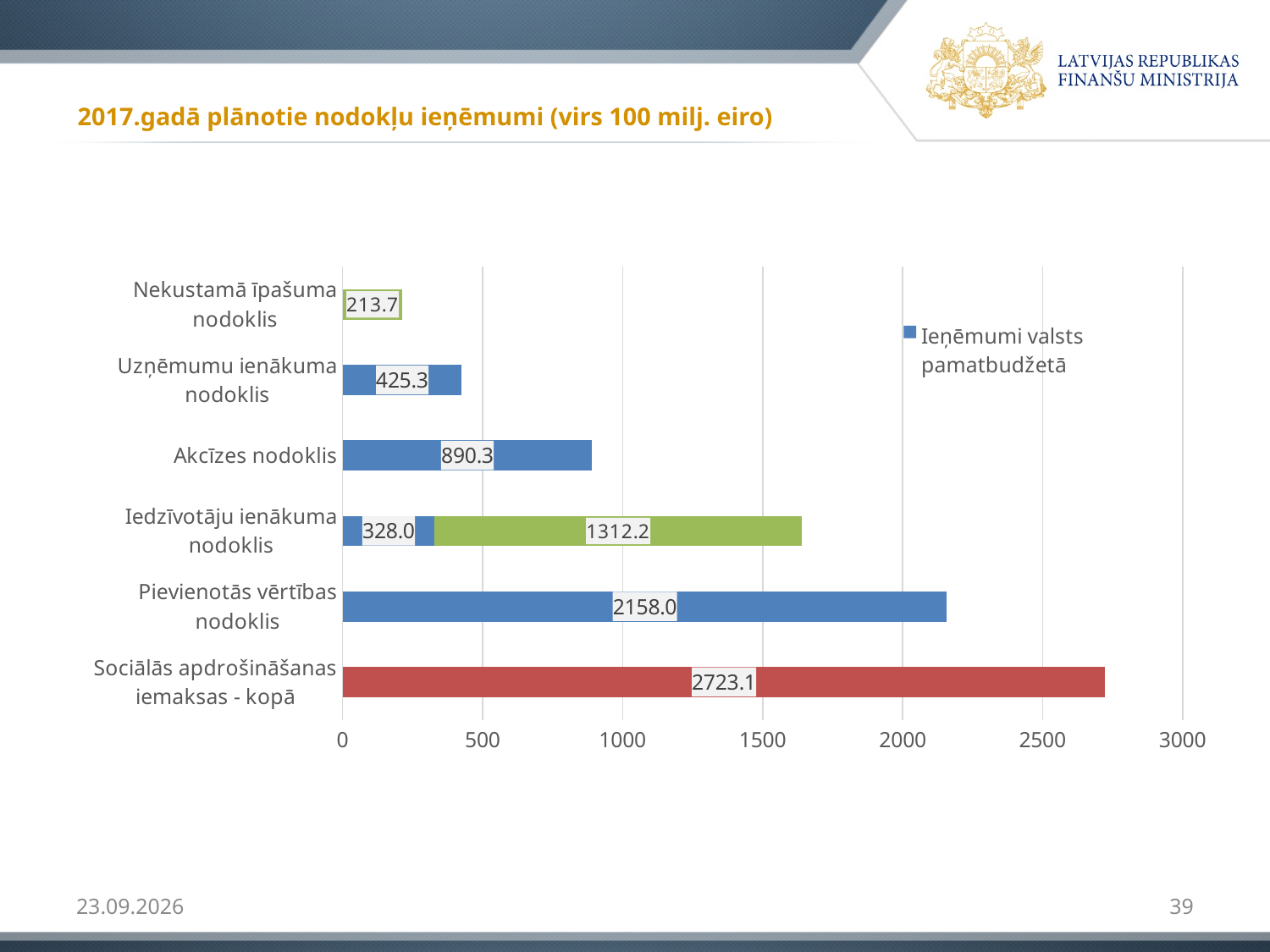
How many categories are shown on the chart? 6 Which category has the longest bar? Sociālās apdrošināšanas iemaksas - kopā What is the legend entry shown on the chart? Ieņēmumi valsts pamatbudžetā Which category has the shortest bar? Nekustamā īpašuma nodoklis What is the value of the blue segment for Iedzīvotāju ienākuma nodoklis? 328.0 What is the total of the two segments for Iedzīvotāju ienākuma nodoklis? 1640.2 Which is larger, the value for Pievienotās vērtības nodoklis or the value for Sociālās apdrošināšanas iemaksas - kopā? Sociālās apdrošināšanas iemaksas - kopā What is the value shown for Akcīzes nodoklis? 890.3 What is the value shown for Pievienotās vērtības nodoklis? 2158.0 What kind of chart is shown on the slide? Bar chart What is the difference between the values for Akcīzes nodoklis and Uzņēmumu ienākuma nodoklis? 465.0 What is the value shown for Sociālās apdrošināšanas iemaksas - kopā? 2723.1